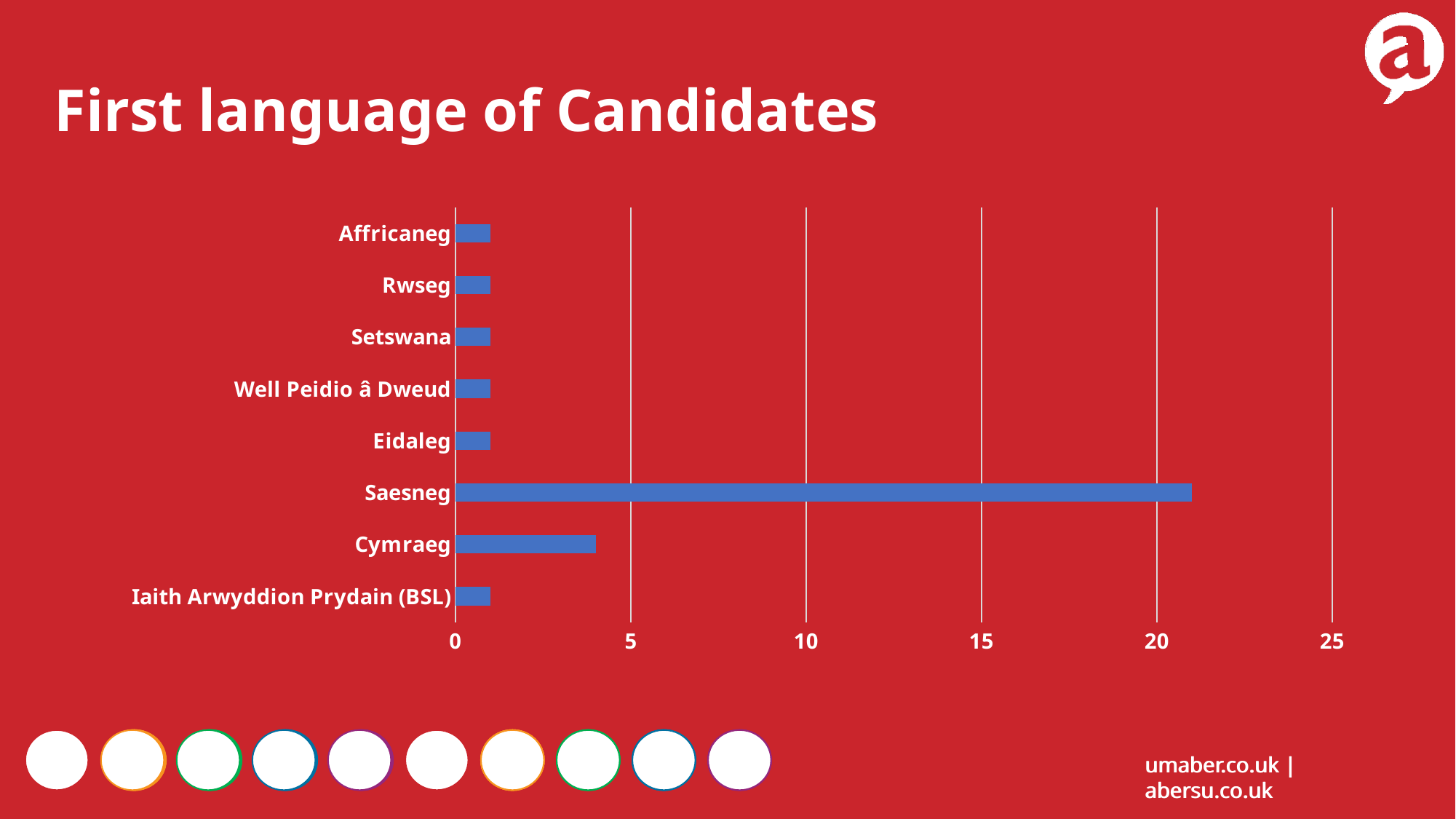
Is the value for Saesneg greater or less than 25? less Which is larger, the value for Cymraeg or the value for Eidaleg? Cymraeg What is the highest value shown on the horizontal axis? 25 Is the value for Affricaneg greater or less than 5? less How many language categories are shown in the chart? 8 What type of chart is shown on the slide? bar chart Is the value for Saesneg greater or less than 20? greater Which is larger, the value for Saesneg or the value for Cymraeg? Saesneg Which language has the second-longest bar in the chart? Cymraeg Which language has the highest number of candidates? Saesneg What is the title of the chart? First language of Candidates